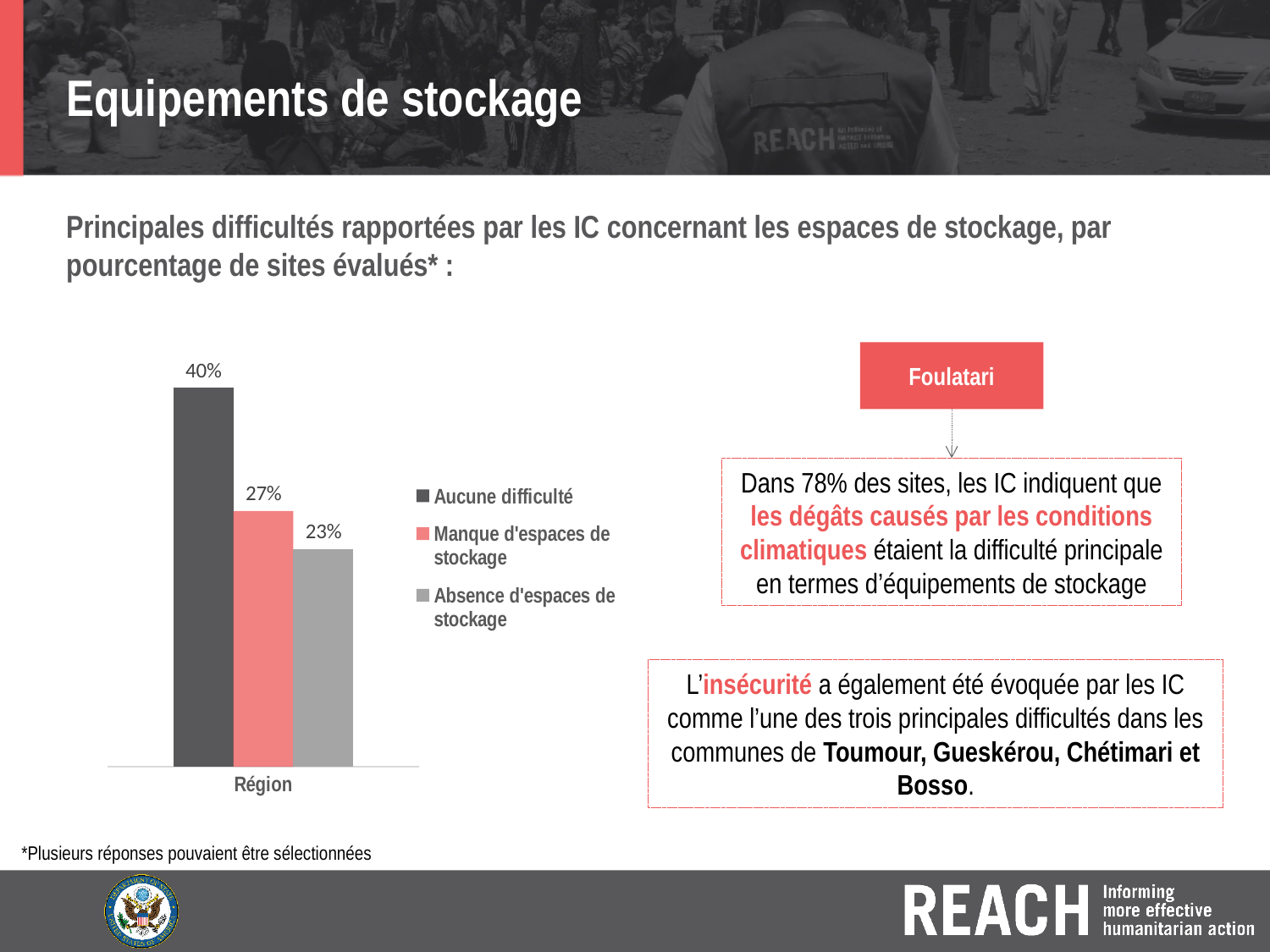
Which series has the highest value in the chart? Aucune difficulté Which colour represents 'Manque d'espaces de stockage' in the chart? Red (pink) What is the value for 'Manque d'espaces de stockage' in the chart? 27% What kind of chart is shown on the slide? Bar chart What percentage of sites reported 'Aucune difficulté' for the Région category? 40% Which series has the lowest value in the chart? Absence d'espaces de stockage How many series does the legend list? 3 Which is larger: the value for 'Aucune difficulté' or the value for 'Absence d'espaces de stockage'? Aucune difficulté What is the category label shown on the x axis of the chart? Région What is the difference between the values for 'Manque d'espaces de stockage' and 'Absence d'espaces de stockage'? 4% What is the value for 'Absence d'espaces de stockage' in the chart? 23% What is the difference between the values for 'Aucune difficulté' and 'Manque d'espaces de stockage'? 13%